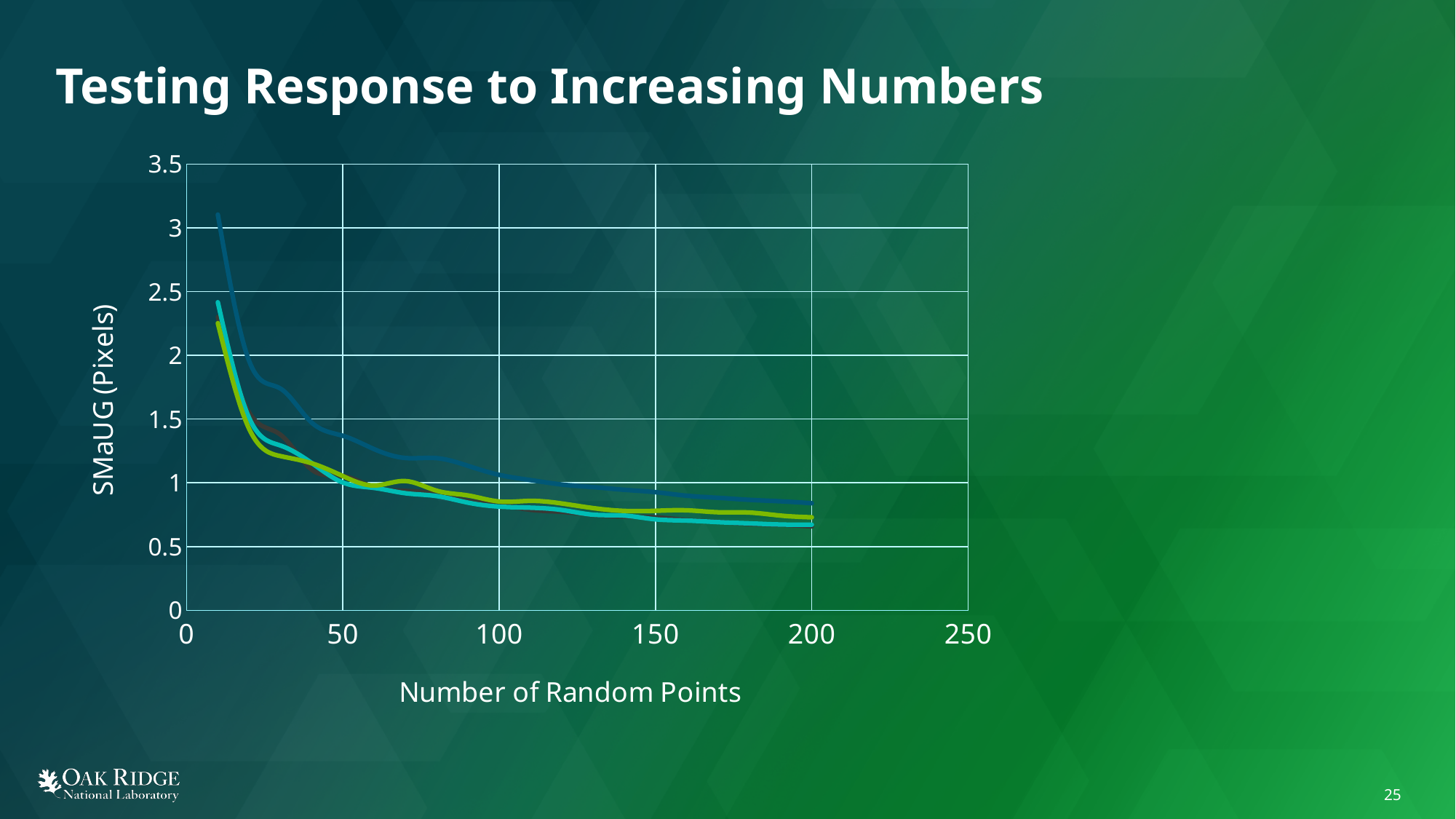
Is the value of the dark blue line at 200 random points greater or less than 0.5? greater Is the value of the dark blue line at 200 random points greater or less than 1? less What kind of chart is shown on the slide? Line chart What is the title of the slide containing the chart? Testing Response to Increasing Numbers What is the label of the y axis? SMaUG (Pixels) Is the value of the dark blue line at 50 random points greater or less than 1? greater Which line has the highest value at 100 random points, the dark blue line or the cyan line? Dark blue line Do the plotted values rise or fall as the number of random points increases? Fall